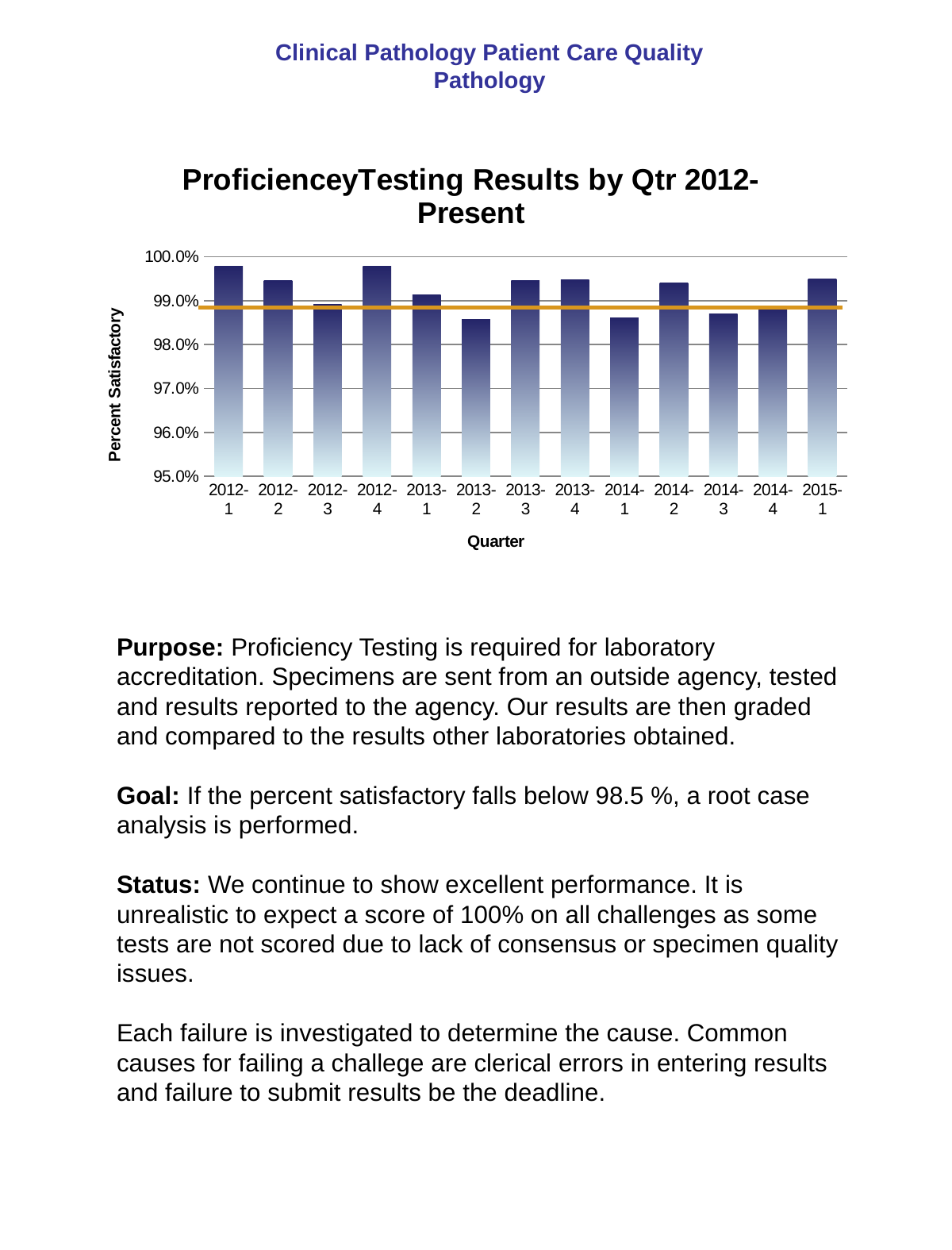
Which quarter has the higher value, 2014-1 or 2013-4? 2013-4 Which quarter has the higher value, 2014-3 or 2012-2? 2012-2 Is the value for 2014-3 greater or less than 99.0%? less What kind of chart is shown on the slide? bar chart Which quarter has the higher value, 2012-1 or 2013-2? 2012-1 Is the value for 2012-1 greater or less than 99.0%? greater Is the value for 2013-2 greater or less than 99.0%? less What is the title of the chart? ProficienceyTesting Results by Qtr 2012-Present How many quarters are plotted on the x axis of the chart? 13 What is the label of the vertical axis of the chart? Percent Satisfactory